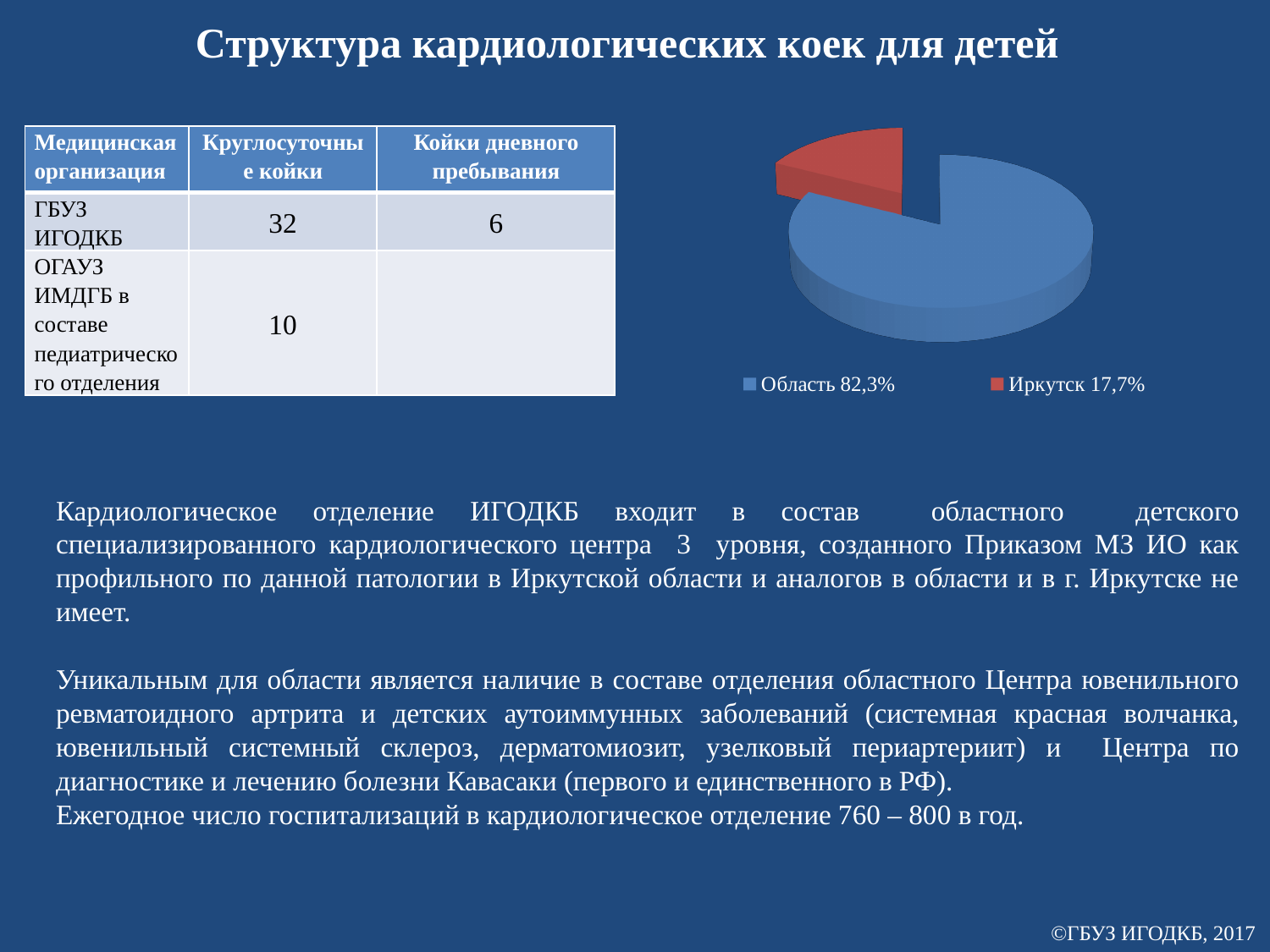
How many slices does the pie chart have? 2 What colour is the Область slice in the pie chart? blue What share of the pie does Иркутск account for? 17,7% Which is larger in the pie chart, Область or Иркутск? Область Which slice of the pie chart is the smallest? Иркутск What colour is the Иркутск slice in the pie chart? red What is the difference in percentage points between the Область and Иркутск slices? 64,6% What kind of chart is shown on the slide? pie chart How many entries does the legend of the pie chart list? 2 Which slice of the pie chart is the largest? Область What share of the pie does Область account for? 82,3%